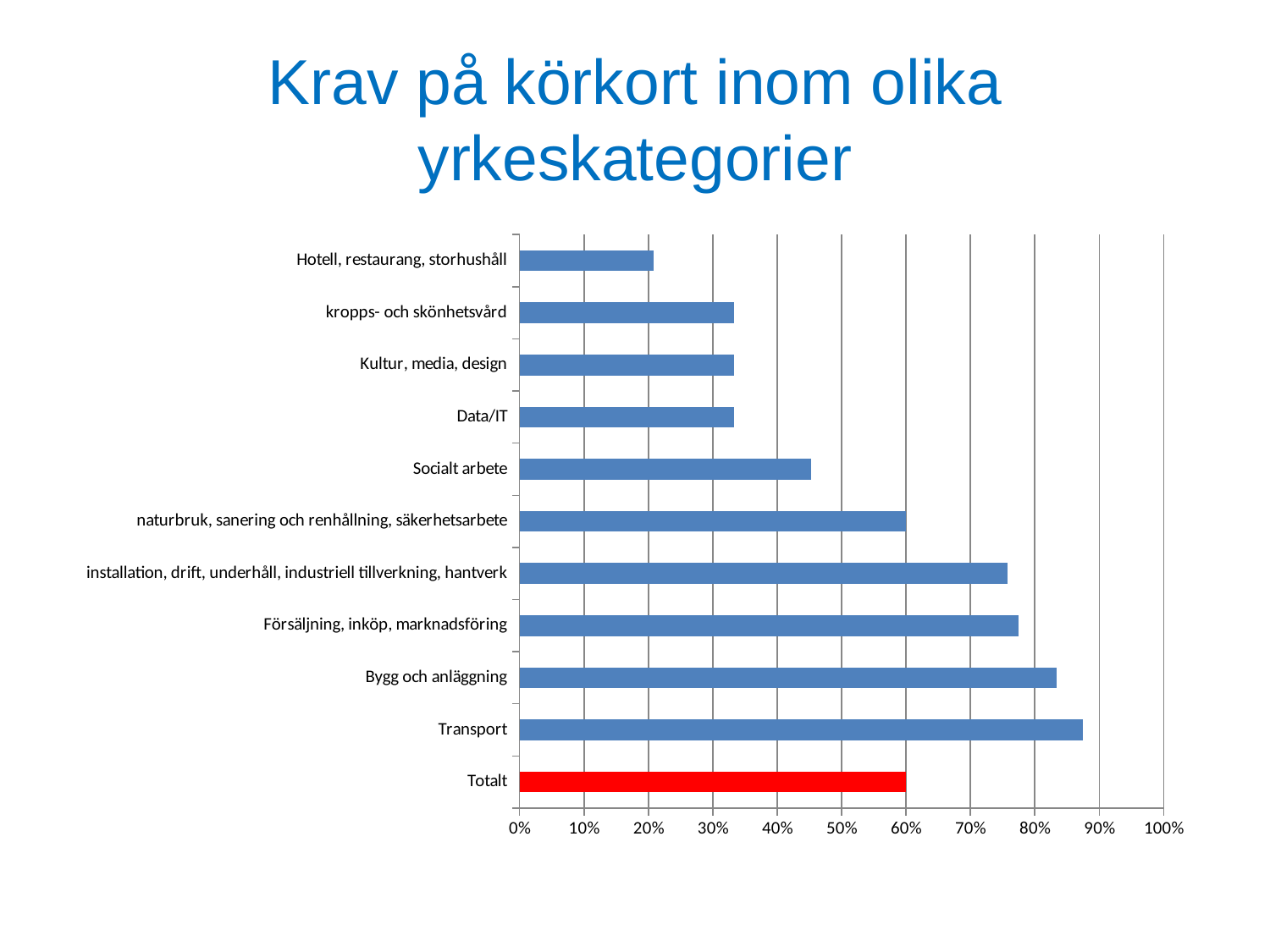
Which is larger, the value for Bygg och anläggning or the value for naturbruk, sanering och renhållning, säkerhetsarbete? Bygg och anläggning Which is larger, the value for Socialt arbete or the value for Kultur, media, design? Socialt arbete Which category's bar is coloured red instead of blue? Totalt Is the value for Bygg och anläggning greater or less than 90%? less Which category has the lowest value? Hotell, restaurang, storhushåll Is the value for Hotell, restaurang, storhushåll greater or less than 30%? less Which category has the highest value? Transport How many categories are plotted on the chart? 11 Is the value for Transport greater or less than 80%? greater What kind of chart is shown on the slide? bar chart